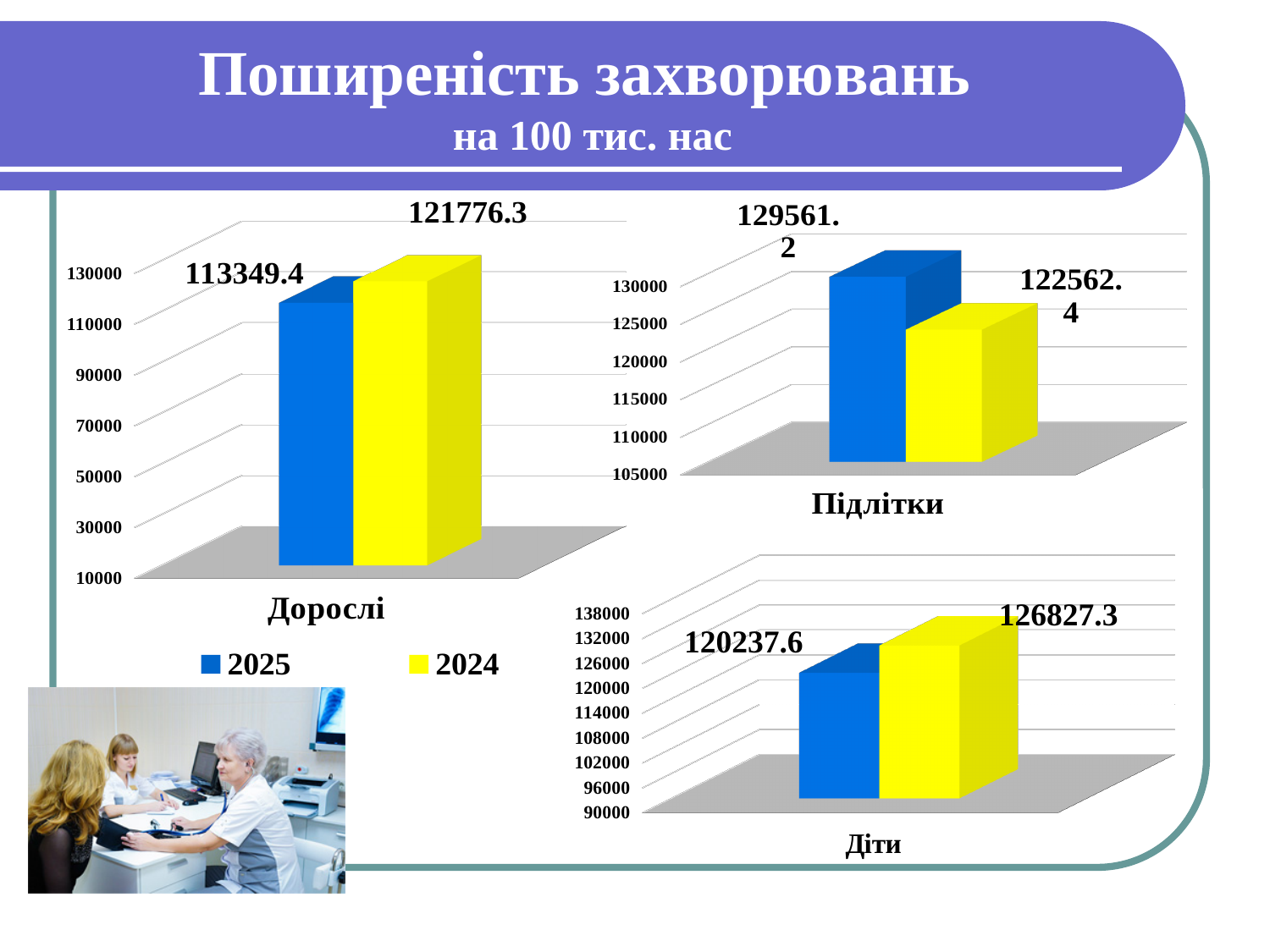
In the chart titled "Діти", what is the difference between the 2024 and 2025 values? 6589.7 In the chart titled "Дорослі", which year has the larger value, 2025 or 2024? 2024 In the chart titled "Діти", what is the value for 2024? 126827.3 In the chart titled "Підлітки", which year has the larger value, 2025 or 2024? 2025 In the chart titled "Діти", what is the value for 2025? 120237.6 In the chart titled "Підлітки", what is the value for 2024? 122562.4 In the chart titled "Підлітки", what is the value for 2025? 129561.2 How many series does the legend under the "Дорослі" chart list? 2 In the chart titled "Дорослі", what is the difference between the 2024 and 2025 values? 8426.9 In the chart titled "Дорослі", what is the value for 2025? 113349.4 What kind of chart is the chart titled "Діти"? Bar chart In the chart titled "Дорослі", what is the value for 2024? 121776.3